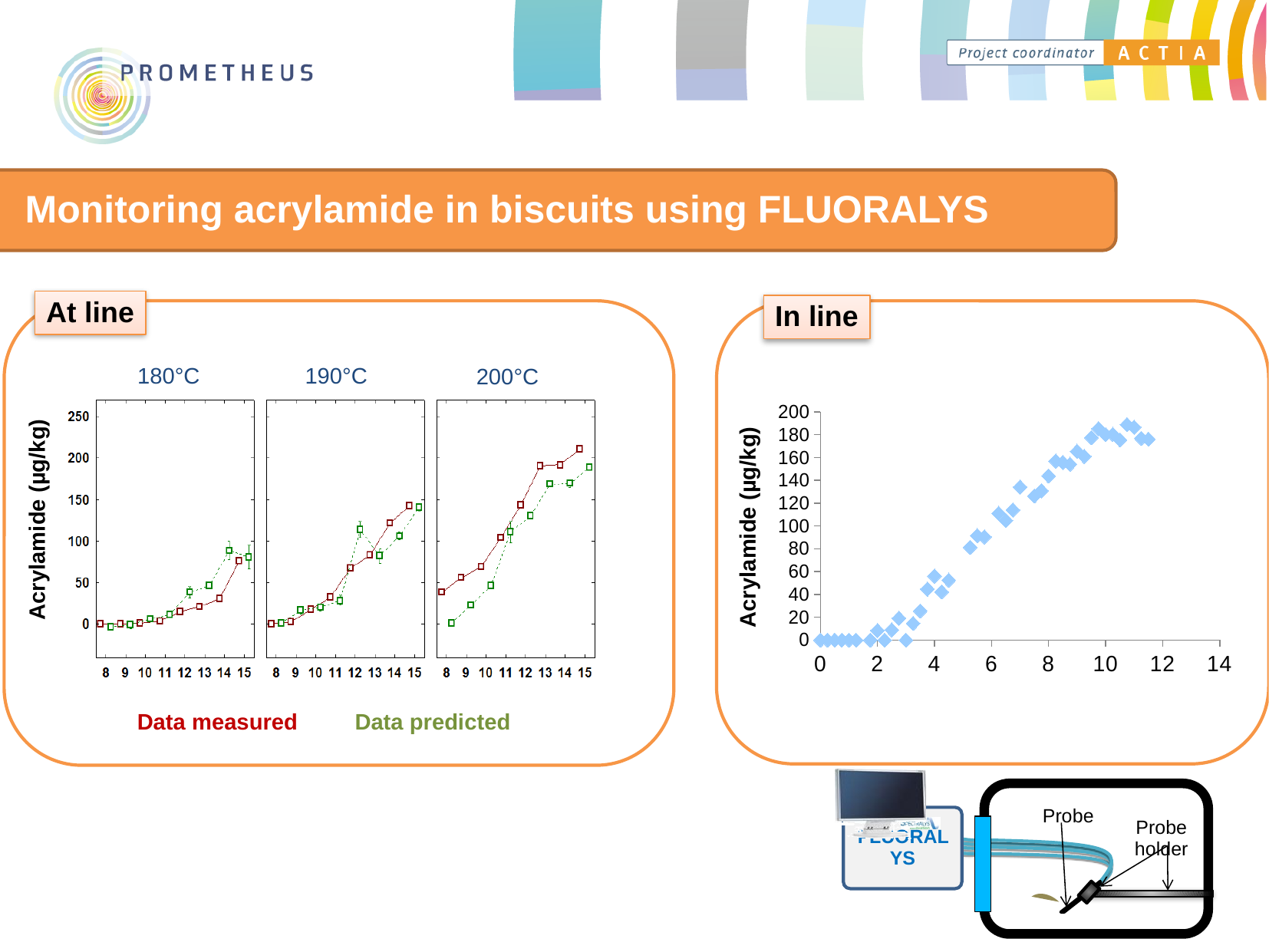
In the 'In line' chart, is the value plotted at x = 0 greater or less than 20? less In the 'In line' chart, do the acrylamide values generally rise or fall as the x-axis value increases? rise In the 'In line' chart, is the highest plotted value greater or less than 160? greater In the 'At line' 180°C panel, is the 'Data measured' value at x = 15 greater or less than 100? less What is the y-axis label of the 'In line' chart? Acrylamide (µg/kg) What kind of chart is shown in the 'In line' panel? scatter chart How many series does the legend of the 'At line' charts list? 2 What are the two series named in the legend of the 'At line' charts? Data measured, Data predicted Among the 'At line' panels, which temperature reaches the highest acrylamide values? 200°C How many temperature panels are shown in the 'At line' charts? 3